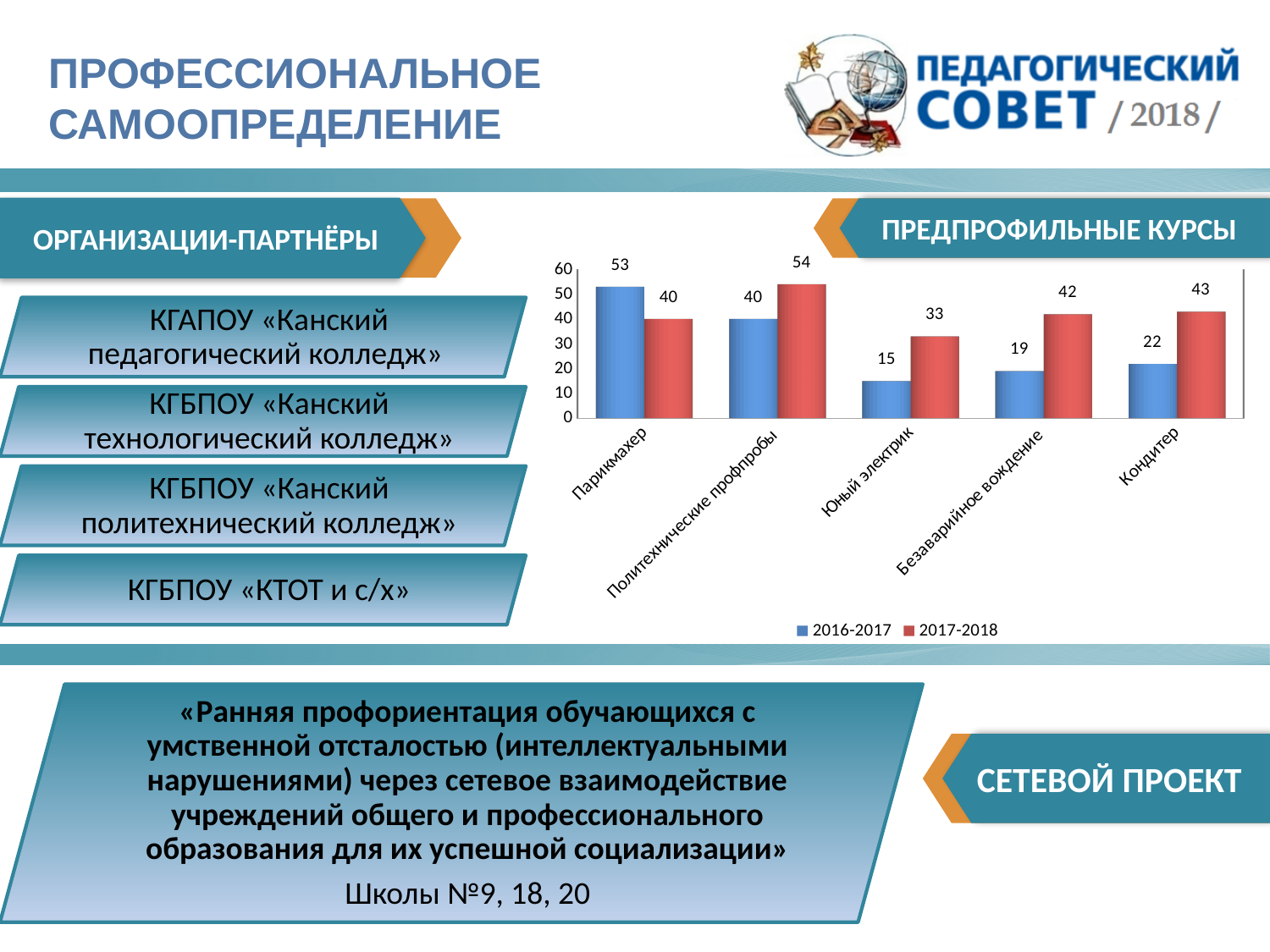
Which is larger for Парикмахер: the 2016-2017 value or the 2017-2018 value? 2016-2017 What is the value for Юный электрик in the 2016-2017 series? 15 What is the value for Политехнические профпробы in the 2017-2018 series? 54 What kind of chart is shown on the slide? Bar chart Which category has the highest value in the 2017-2018 series? Политехнические профпробы How many series does the chart legend list? 2 Which category has the lowest value in the 2016-2017 series? Юный электрик What is the value for Парикмахер in the 2016-2017 series? 53 How many categories are shown on the x axis of the chart? 5 Which series is shown in red in the chart? 2017-2018 What is the difference between the 2016-2017 values for Парикмахер and Кондитер? 31 What is the difference between the 2017-2018 and 2016-2017 values for Безаварийное вождение? 23